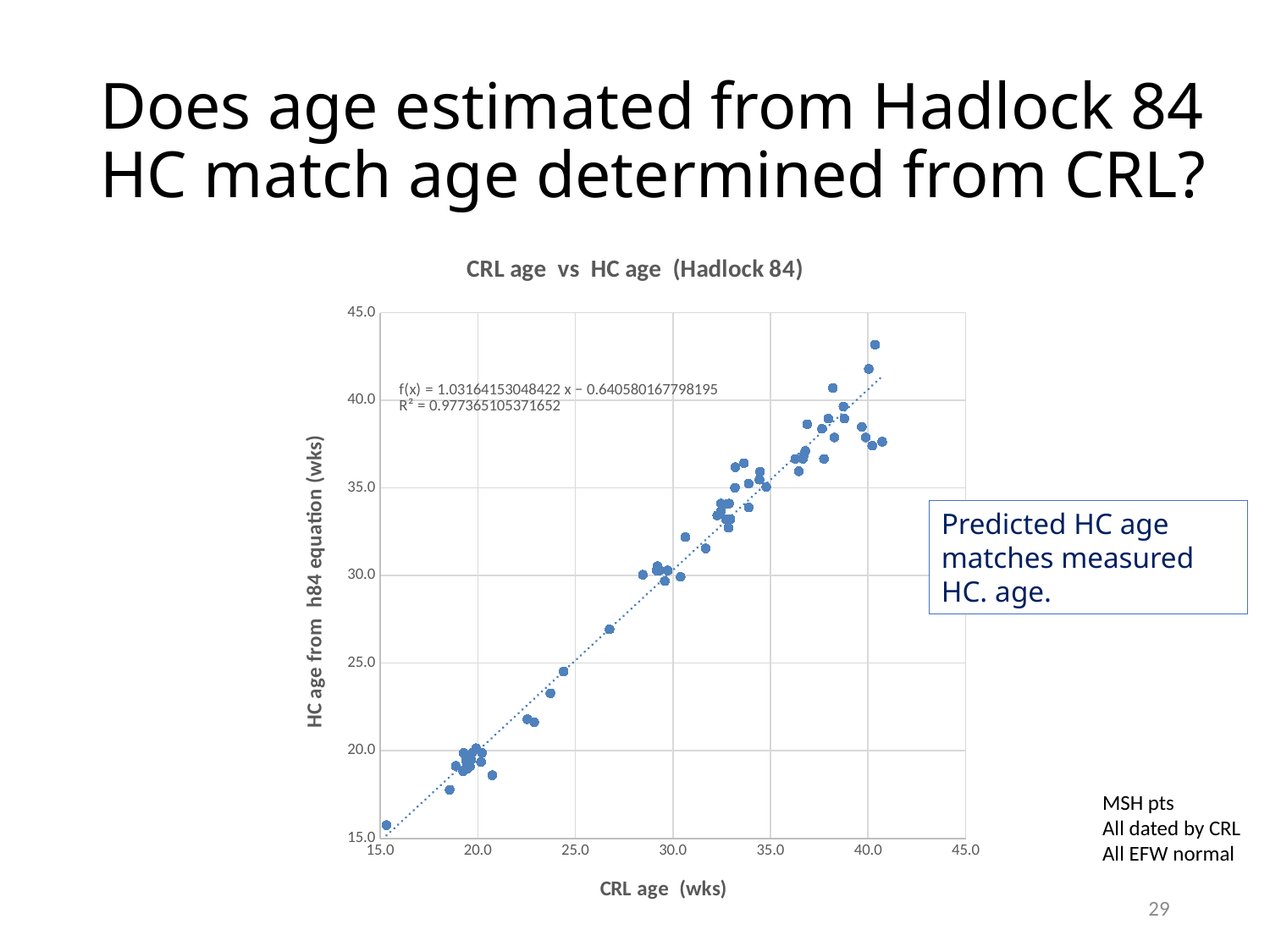
Is the lowest HC age value plotted on the chart greater or less than 20.0? less What is the slope (coefficient of x) in the fitted line equation printed on the chart? 1.03164153048422 What is the lowest tick value shown on the x axis of the chart? 15.0 Is the highest HC age value plotted on the chart greater or less than 40.0? greater What kind of chart is shown on the slide? Scatter chart Do the HC age values rise or fall as CRL age increases along the x axis? Rise Is the HC age value for the point with the largest CRL age greater or less than 35.0? greater What is the label of the x axis of the chart? CRL age (wks) What is the intercept in the fitted line equation printed on the chart? −0.640580167798195 What R² value is printed on the chart for the fitted line? 0.977365105371652 What is the highest tick value shown on the y axis of the chart? 45.0 What is the title of the chart? CRL age vs HC age (Hadlock 84)